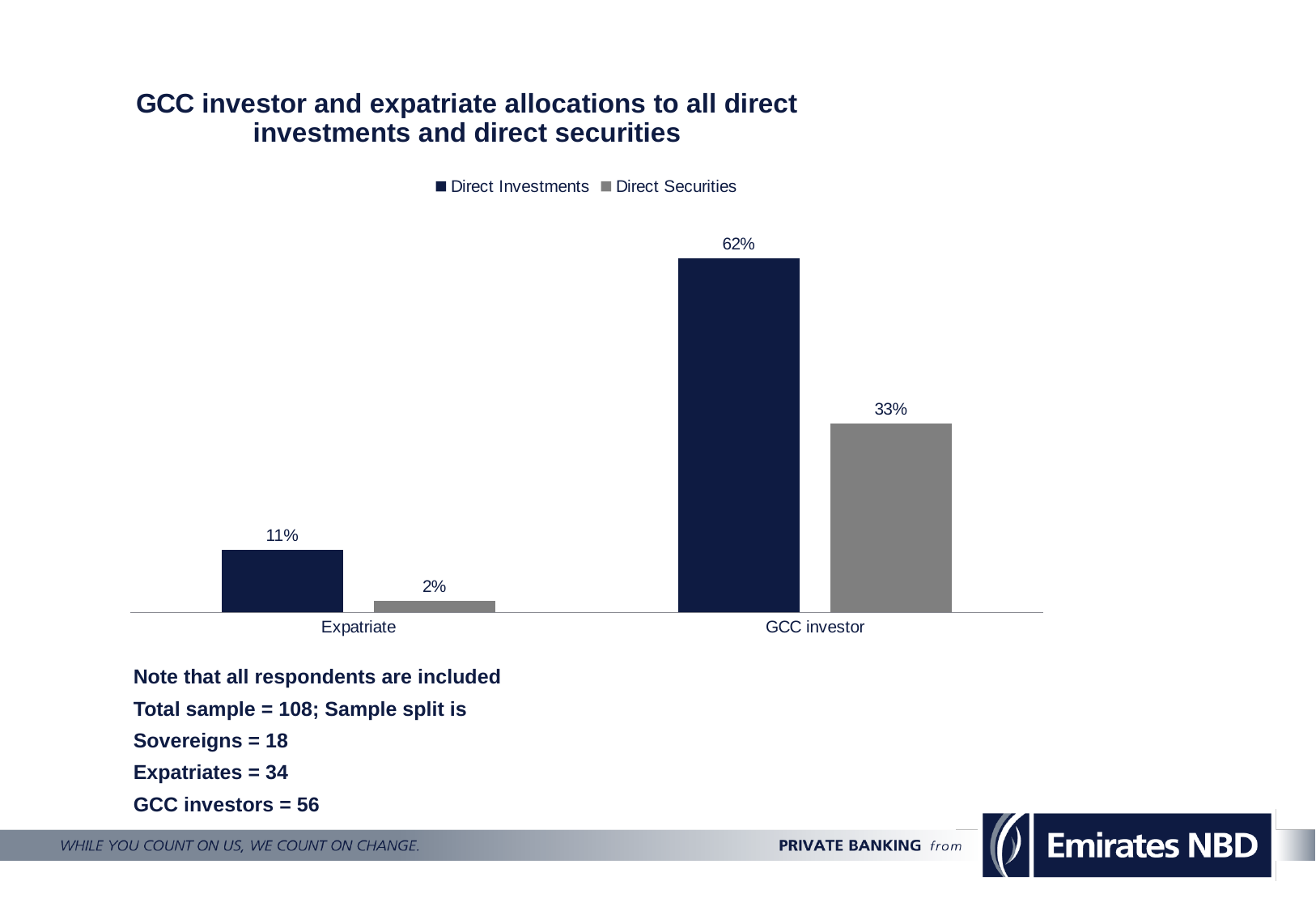
What is the Direct Investments value for GCC investor? 62% Which category has the highest Direct Investments value? GCC investor How many series does the legend list? 2 What is the difference between the Direct Investments and Direct Securities values for GCC investor? 29% What is the difference between the Direct Investments values for GCC investor and Expatriate? 51% What is the Direct Investments value for Expatriate? 11% What is the Direct Securities value for Expatriate? 2% Which is larger for Expatriate: Direct Investments or Direct Securities? Direct Investments What kind of chart is shown on the slide? Bar chart What is the Direct Securities value for GCC investor? 33% How many categories are shown on the x axis? 2 Which category has the lowest Direct Securities value? Expatriate